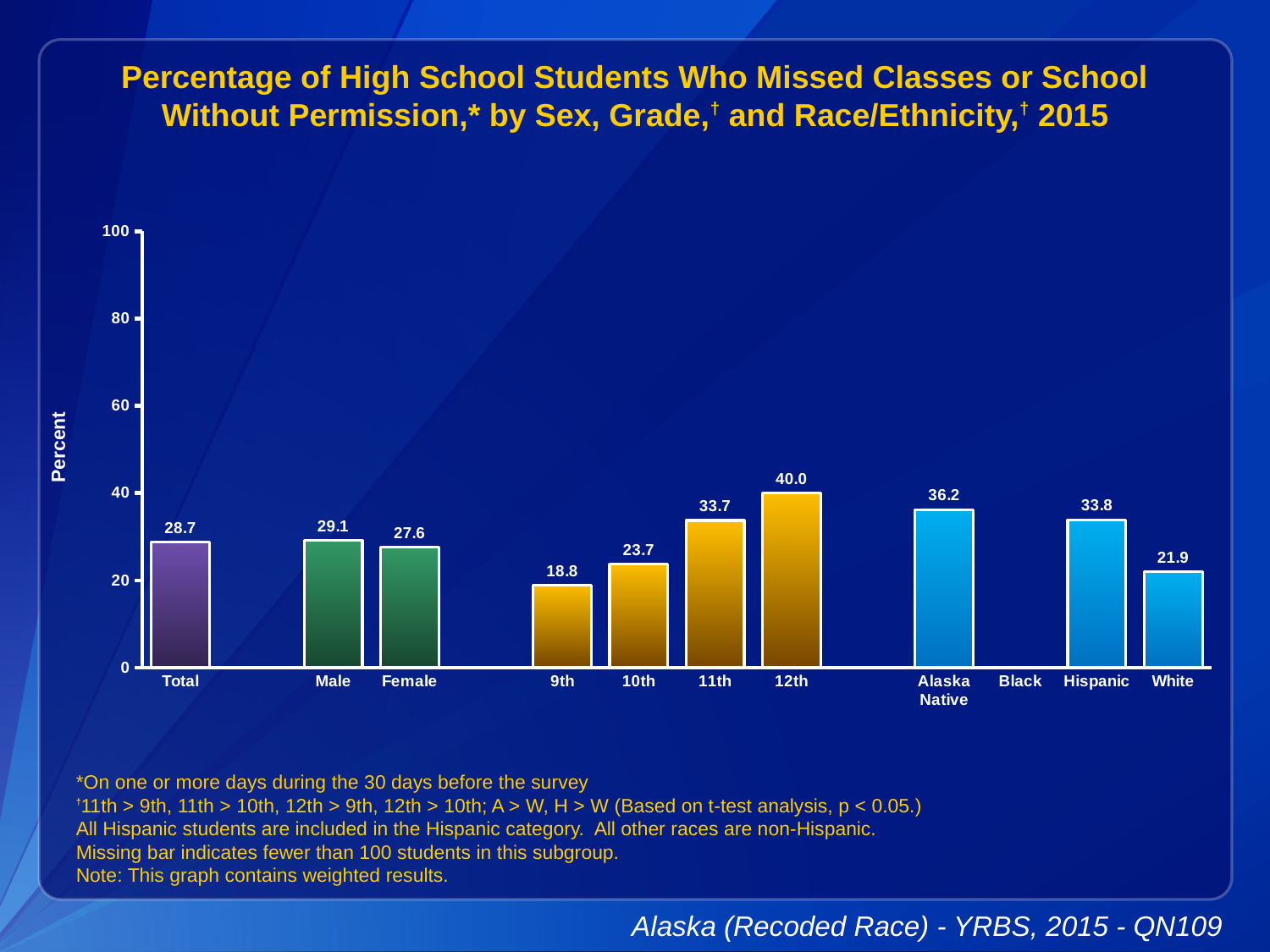
Which category label has no bar shown? Black What is the value for Total? 28.7 Which category has the lowest value? 9th Which is larger, the value for Hispanic or the value for White? Hispanic What is the value for 12th grade? 40.0 What is the value for Alaska Native? 36.2 What is the difference between the Male and Female values? 1.5 Which category has the highest value? 12th Is the value for 11th grade greater or less than 40? less Do the values rise or fall from 9th grade to 12th grade? rise What kind of chart is shown? bar chart How many bars are plotted on the chart? 10